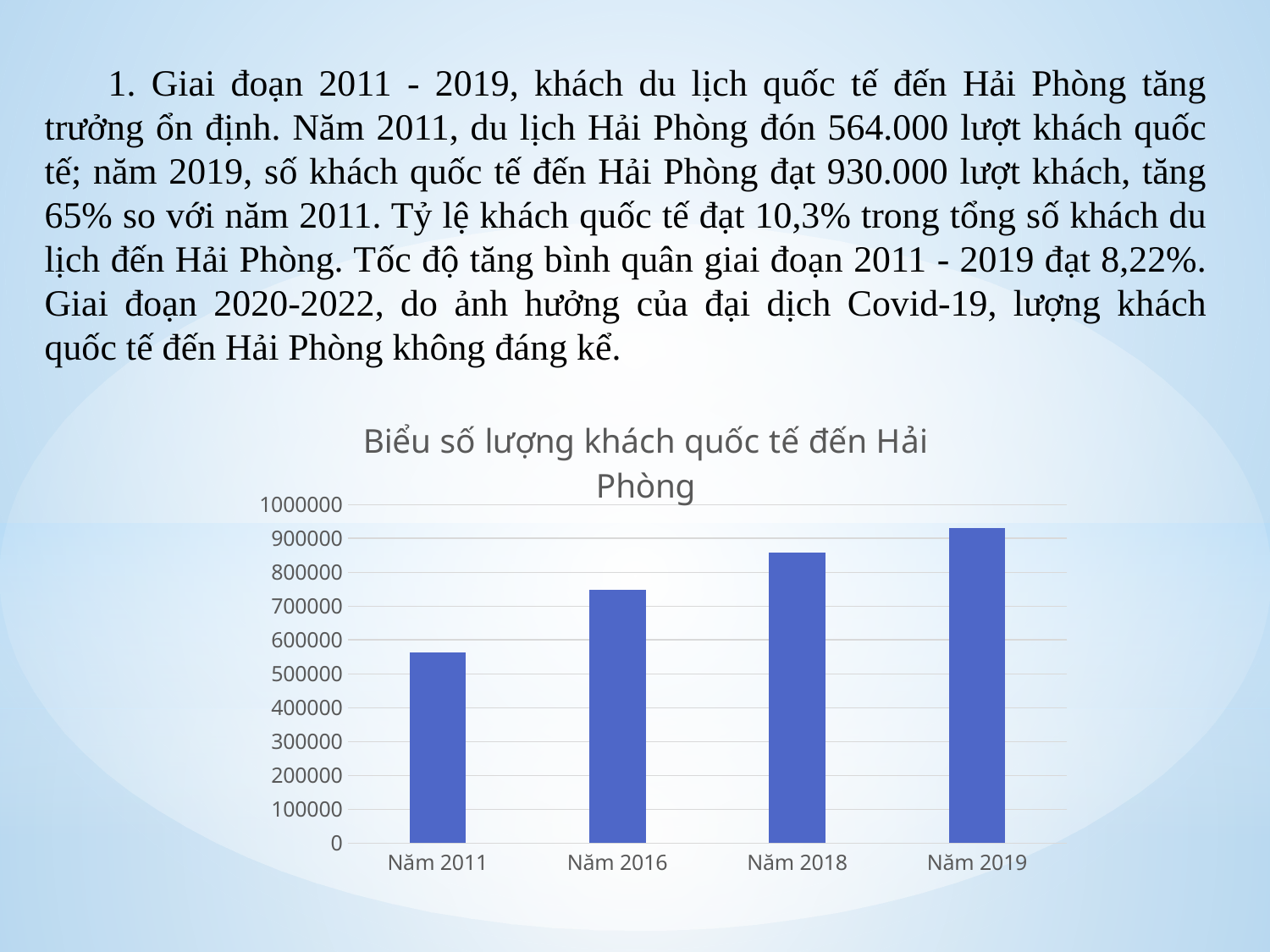
What is the maximum value shown on the vertical axis of the chart? 1000000 Is the value for Năm 2016 greater or less than 700000? greater Do the values rise or fall from Năm 2011 to Năm 2019 along the x axis? rise What type of chart is shown on the slide? bar chart Which is larger, the value for Năm 2016 or the value for Năm 2018? Năm 2018 Is the value for Năm 2019 greater or less than 900000? greater Which year has the highest bar in the chart? Năm 2019 What is the title of the chart? Biểu số lượng khách quốc tế đến Hải Phòng Is the value for Năm 2018 greater or less than 900000? less Which year has the lowest bar in the chart? Năm 2011 How many years (categories) are shown on the x axis of the chart? 4